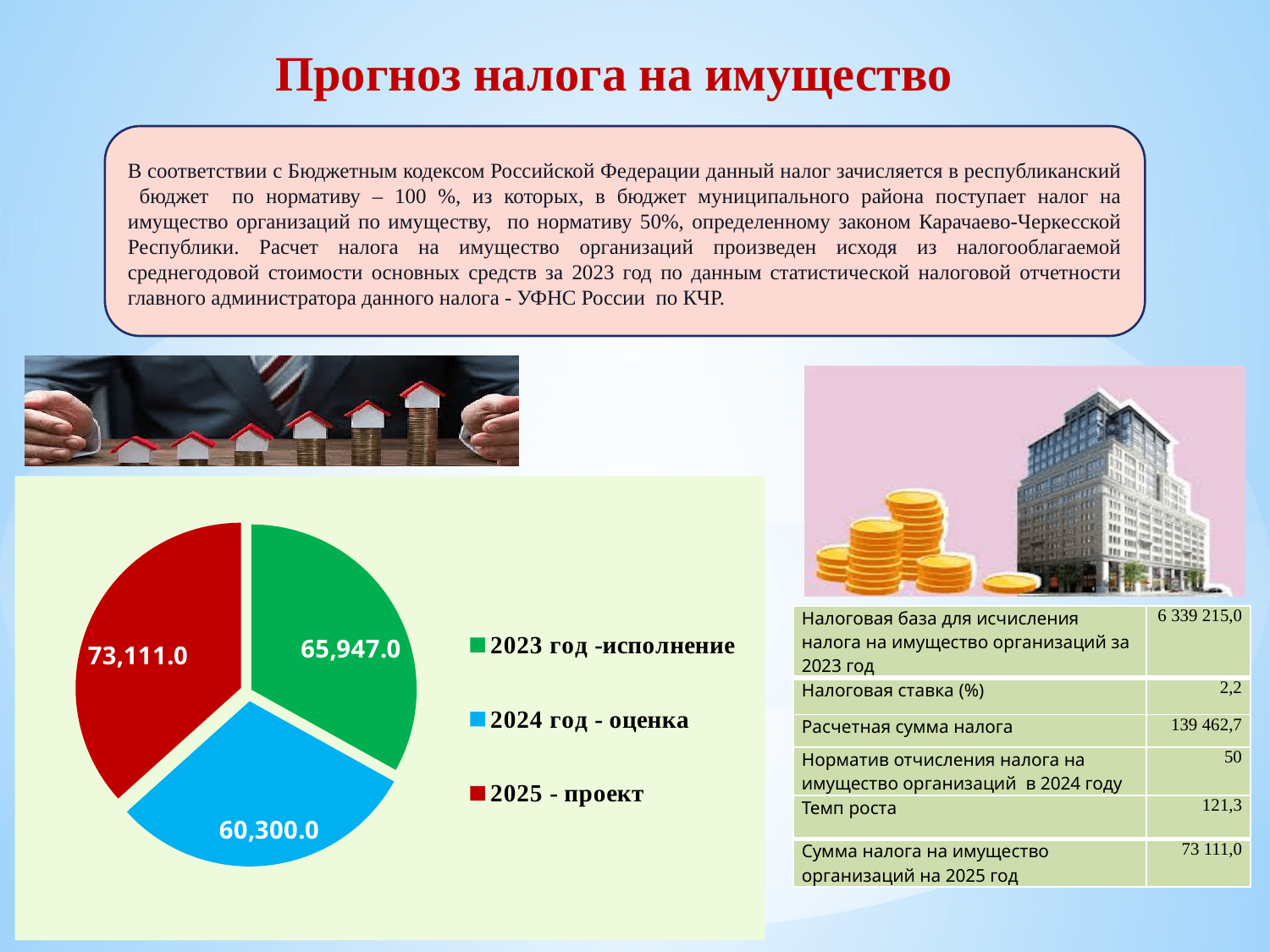
Which category has the largest slice in the pie chart? 2025 - проект What is the value for 2024 год - оценка in the pie chart? 60,300.0 What is the difference between the values for 2023 год -исполнение and 2024 год - оценка? 5,647.0 What is the difference between the values for 2025 - проект and 2023 год -исполнение? 7,164.0 Which category has the smallest slice in the pie chart? 2024 год - оценка What is the value for 2025 - проект in the pie chart? 73,111.0 Which is larger: the value for 2025 - проект or the value for 2024 год - оценка? 2025 - проект What colour is the slice for 2024 год - оценка in the pie chart? blue What type of chart is shown on the slide? pie chart How many slices does the pie chart have? 3 What is the value for 2023 год -исполнение in the pie chart? 65,947.0 What is the total of all slices in the pie chart? 199,358.0